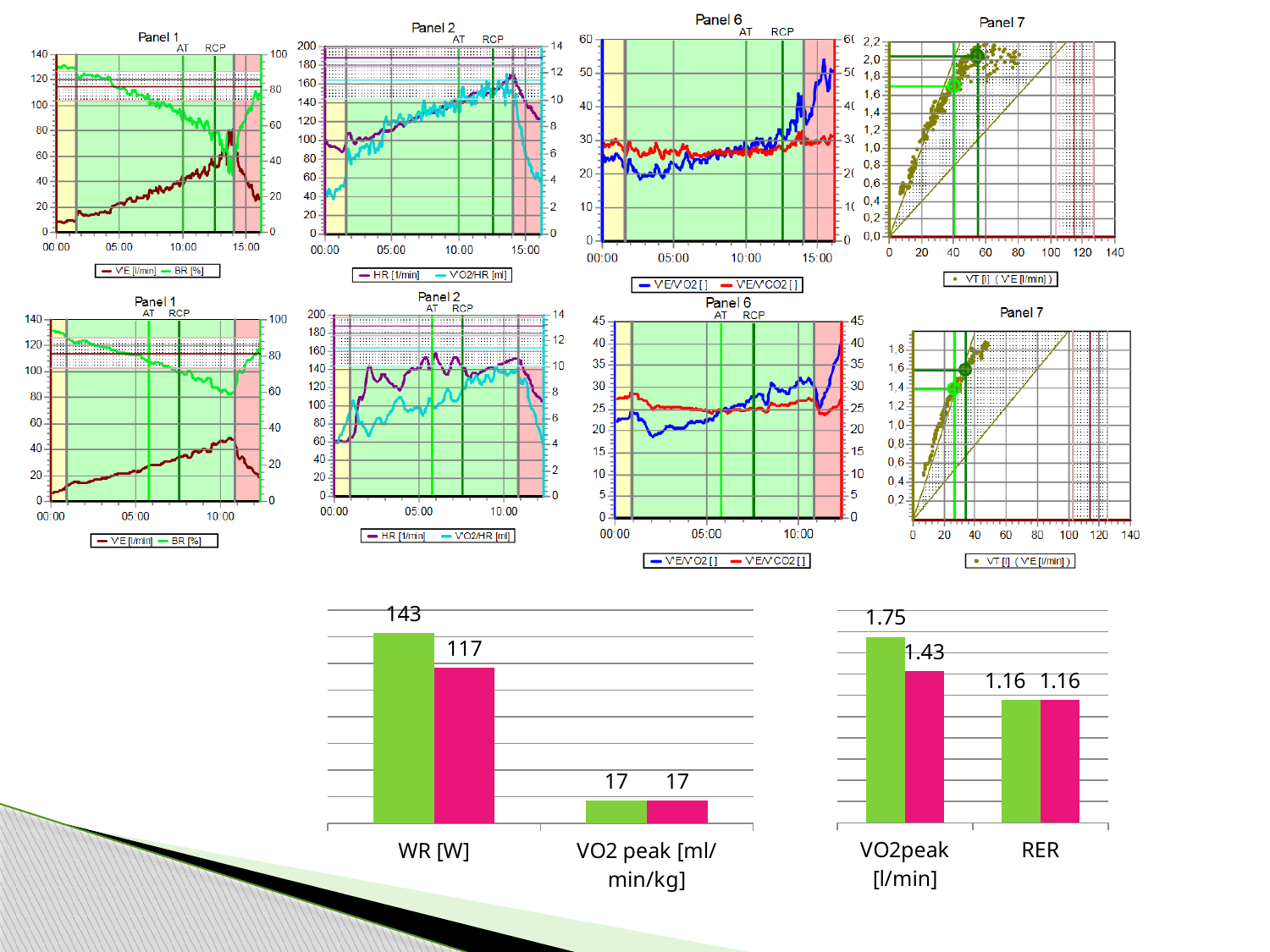
How many categories are shown on the x axis of the bottom-left bar chart? 2 In the bottom-left bar chart, what is the value of the green bar for WR [W]? 143 In the bottom-right bar chart, what is the value of the magenta bar for RER? 1.16 In the bottom-right bar chart, what is the value of the magenta bar for VO2peak [l/min]? 1.43 In the bottom-left bar chart, what is the value of the green bar for VO2 peak [ml/min/kg]? 17 In the bottom-left bar chart, which bar is larger for WR [W], the green one or the magenta one? green How many series does the legend of the top-left Panel 1 chart list? 2 In the bottom-left bar chart, what is the value of the magenta bar for WR [W]? 117 What kind of chart is the bottom-right chart with the categories VO2peak [l/min] and RER? bar chart In the bottom-left bar chart, what is the difference between the green and magenta bars for WR [W]? 26 In the bottom-right bar chart, what is the value of the green bar for VO2peak [l/min]? 1.75 In the bottom-right bar chart, what is the difference between the green and magenta bars for VO2peak [l/min]? 0.32